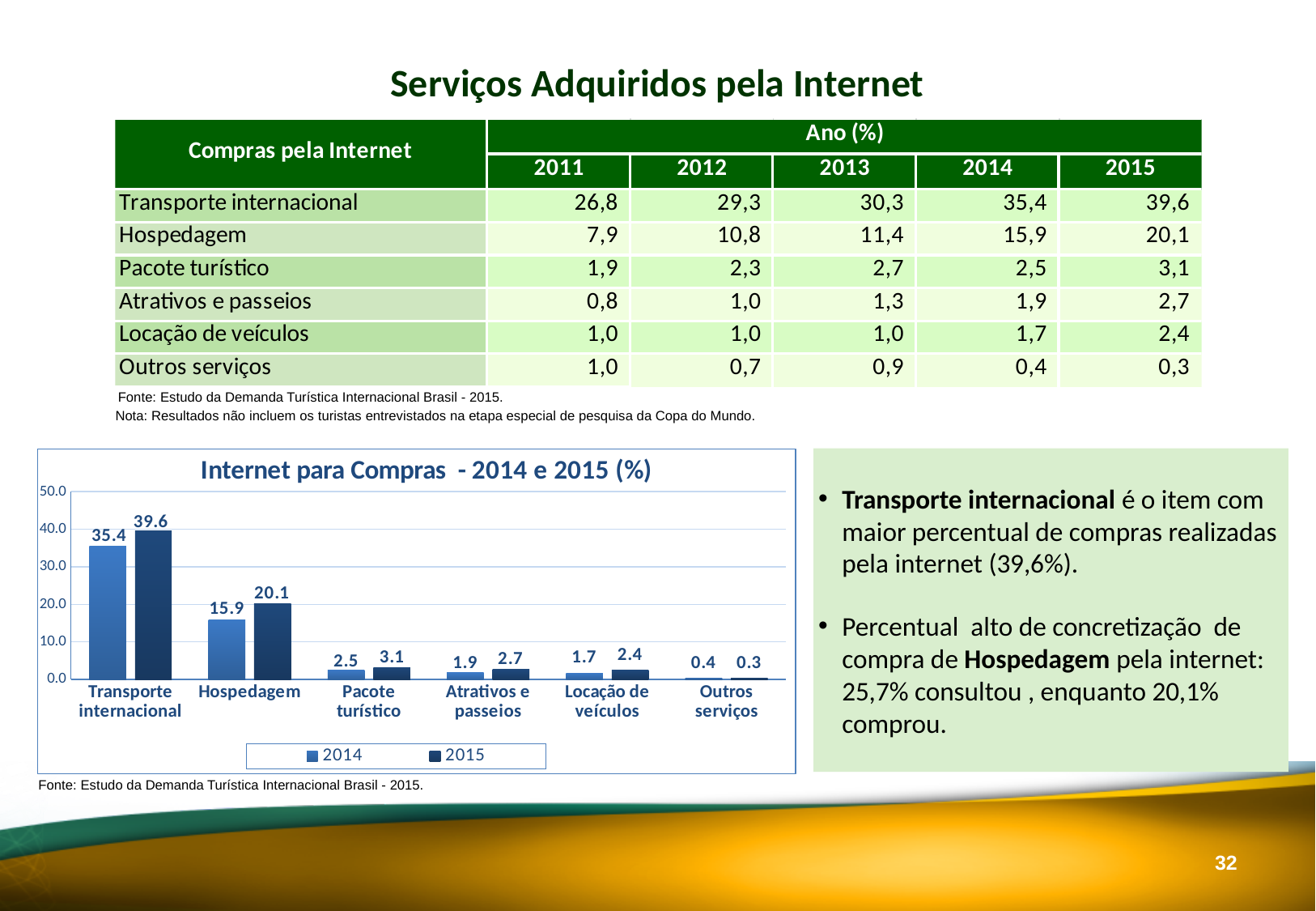
What is the difference between the 2015 and 2014 values for Hospedagem? 4.2 Which is larger for Outros serviços, the 2014 value or the 2015 value? 2014 What is the difference between the 2015 and 2014 values for Transporte internacional? 4.2 What is the value for Locação de veículos in 2015? 2.4 Which category has the highest value in 2015? Transporte internacional How many series does the chart legend list? 2 Which category has the lowest value in 2014? Outros serviços What kind of chart is shown on the slide? bar chart What is the value for Transporte internacional in 2014? 35.4 What is the value for Hospedagem in 2015? 20.1 Is the 2015 value for Transporte internacional greater or less than 30.0? greater How many categories are shown on the x axis of the chart? 6